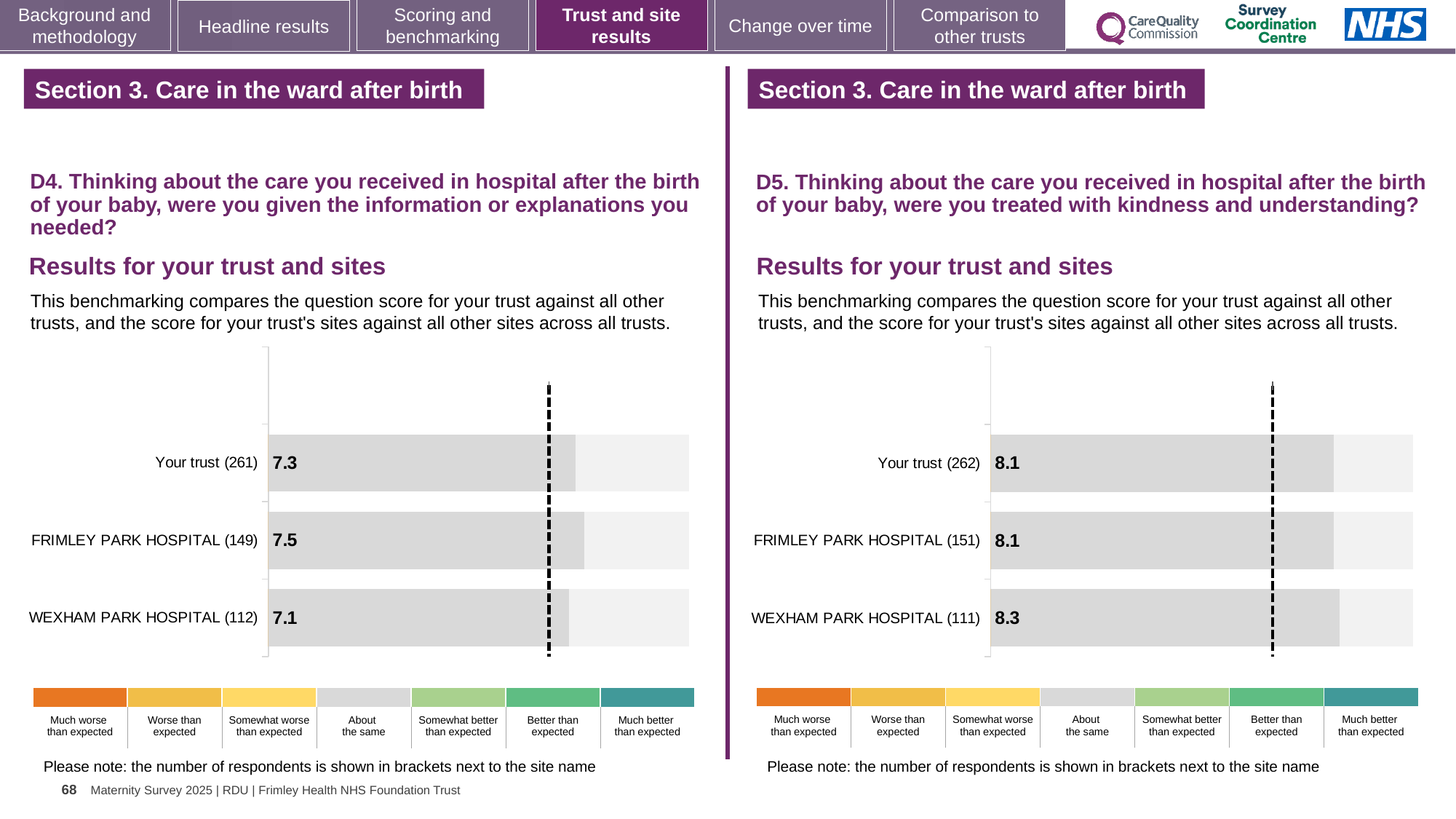
In the D4 chart on the left, which site or trust has the lowest score? WEXHAM PARK HOSPITAL In the D4 chart on the left, what is the score for Your trust? 7.3 In the D5 chart on the right, which site or trust has the highest score? WEXHAM PARK HOSPITAL In the D5 chart on the right, what is the score for Your trust? 8.1 How many bars are plotted in the D5 chart on the right? 3 In the D5 chart on the right, which has the larger score, WEXHAM PARK HOSPITAL or Your trust? WEXHAM PARK HOSPITAL In the D4 chart on the left, what is the difference between the scores for FRIMLEY PARK HOSPITAL and WEXHAM PARK HOSPITAL? 0.4 In the D5 chart on the right, what is the score for WEXHAM PARK HOSPITAL? 8.3 In the D4 chart on the left, what is the score for FRIMLEY PARK HOSPITAL? 7.5 In the D4 chart on the left, which site or trust has the highest score? FRIMLEY PARK HOSPITAL What type of chart is the D4 chart on the left? Bar chart In the D4 chart on the left, what is the score for WEXHAM PARK HOSPITAL? 7.1